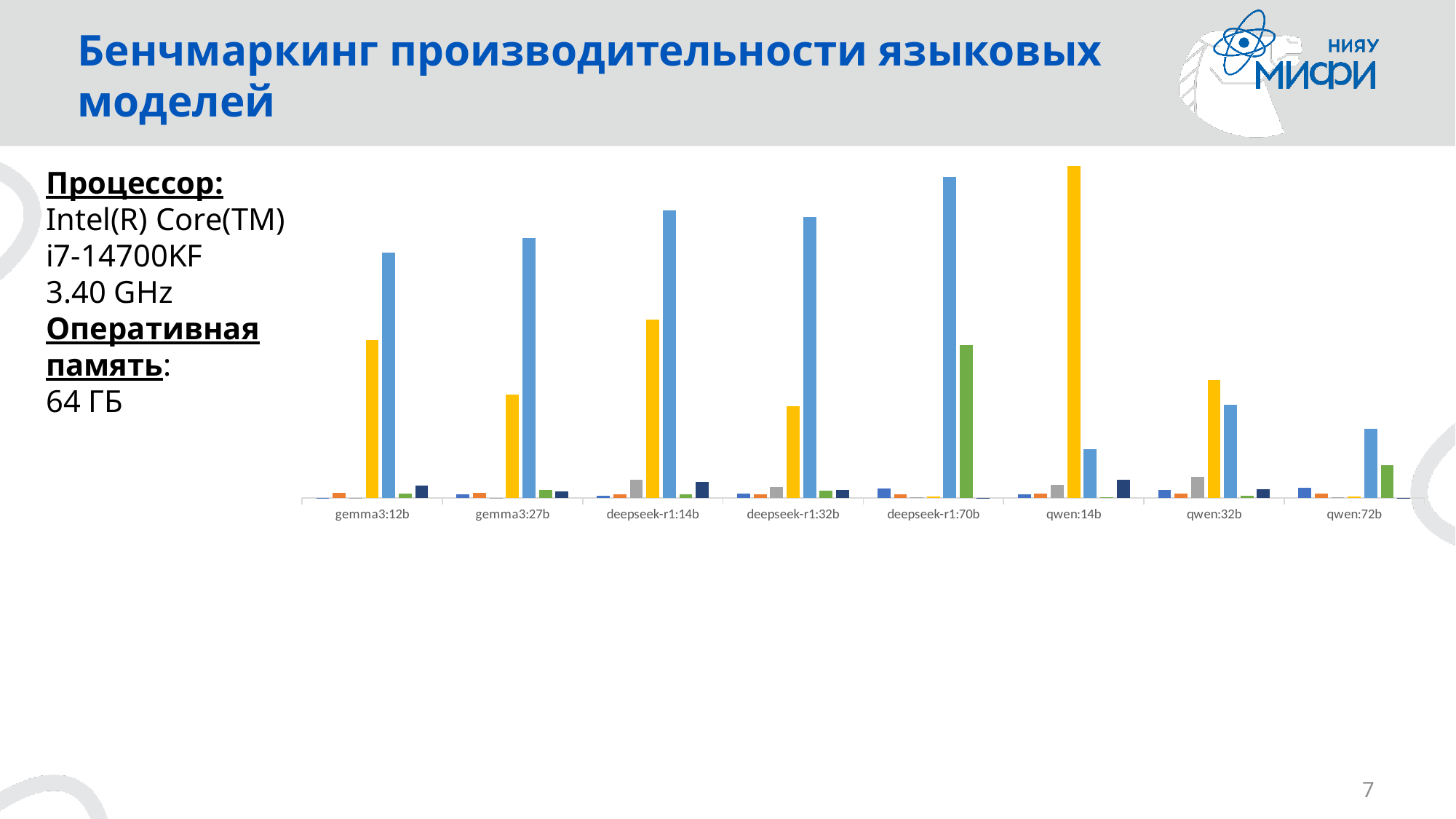
What is the last category label on the x axis of the chart? qwen:72b In the qwen:14b group, which is taller: the yellow bar or the light blue bar? the yellow bar Which category on the x axis has the shortest light blue bar? qwen:14b Which category on the x axis has the tallest light blue bar? deepseek-r1:70b Which category on the x axis has the tallest green bar? deepseek-r1:70b What kind of chart is shown on the slide? bar chart What is the first category label on the x axis of the chart? gemma3:12b Which category on the x axis has the tallest yellow bar? qwen:14b In the gemma3:12b group, which is taller: the yellow bar or the light blue bar? the light blue bar How many model categories are shown along the x axis of the chart? 8 Is the light blue bar for deepseek-r1:70b taller or shorter than the light blue bar for deepseek-r1:32b? taller